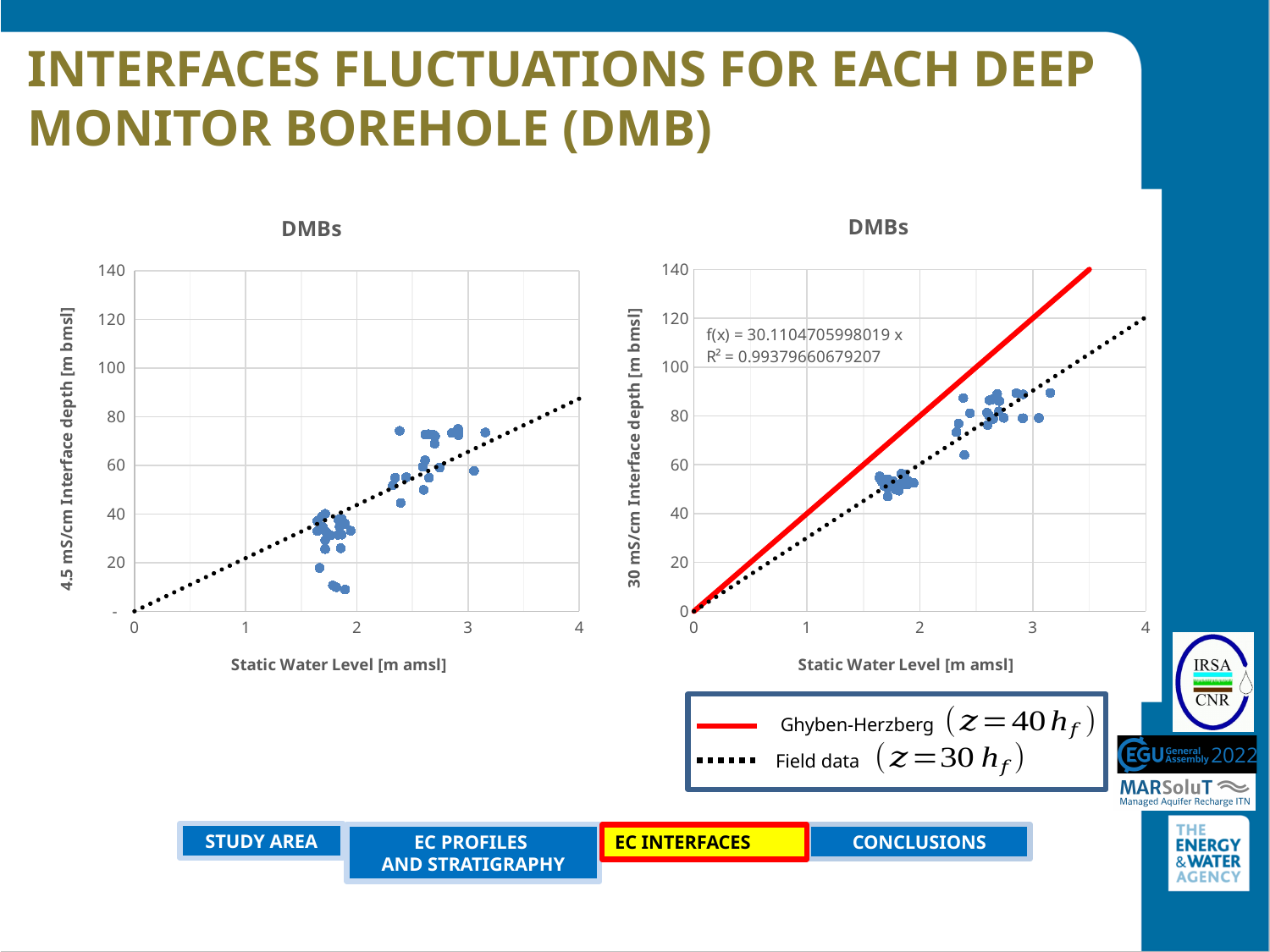
On the right chart, which line is drawn in red: Ghyben-Herzberg or Field data? Ghyben-Herzberg How many entries does the legend below the right chart list? 2 On the right chart (30 mS/cm Interface depth), what R² value is shown for the trendline? R² = 0.99379660679207 On the right chart, are the interface depth values for points at a static water level of about 2.6 m greater or less than 60? greater What type of chart is the left chart titled DMBs? Scatter chart On the right chart, are the interface depth values for points at a static water level of about 1.7 m greater or less than 40? greater On the left chart, are the interface depth values for points at a static water level of about 1.7 m greater or less than 60? less On the left chart, what is the label of the vertical axis? 4.5 mS/cm Interface depth [m bmsl] On the right chart, do the plotted interface depths rise or fall as the static water level increases? Rise On the left chart, do the plotted interface depths rise or fall as the static water level increases? Rise On the right chart, what is the label of the horizontal axis? Static Water Level [m amsl] On the right chart (30 mS/cm Interface depth), what is the trendline equation shown? f(x) = 30.1104705998019 x